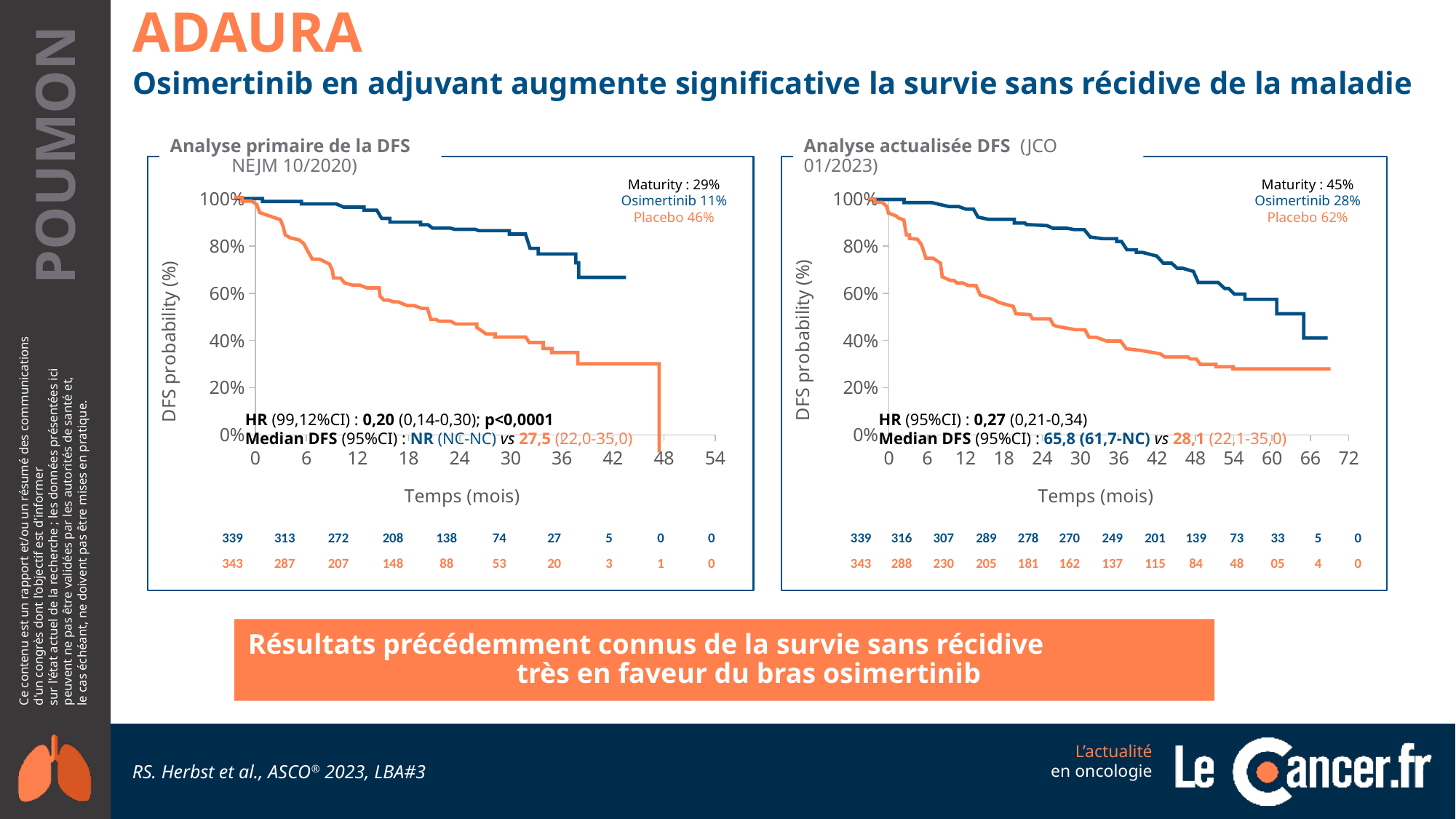
What kind of chart is shown in the 'Analyse primaire de la DFS' panel? Line chart (Kaplan-Meier survival curve) In the 'Analyse actualisée DFS' chart, what is the median DFS for the osimertinib arm? 65,8 In the 'Analyse primaire de la DFS' chart, how do the DFS probability curves change as time increases? They fall In the 'Analyse actualisée DFS' chart, what is the difference between the number of osimertinib patients at risk at 0 months (339) and at 48 months (139)? 200 How many treatment arms (curves) are plotted in the 'Analyse primaire de la DFS' chart? 2 In the 'Analyse actualisée DFS' chart, which arm has the higher DFS probability at 48 months, osimertinib or placebo? Osimertinib In the 'Analyse actualisée DFS' chart, what is the overall maturity? 45% In the 'Analyse actualisée DFS' chart, what is the hazard ratio (HR)? 0,27 In the 'Analyse primaire de la DFS' chart, what is the maturity for the placebo arm? 46% In the 'Analyse primaire de la DFS' chart, is the placebo DFS probability at 24 months greater or less than 60%? less In the 'Analyse primaire de la DFS' chart, what is the median DFS for the placebo arm? 27,5